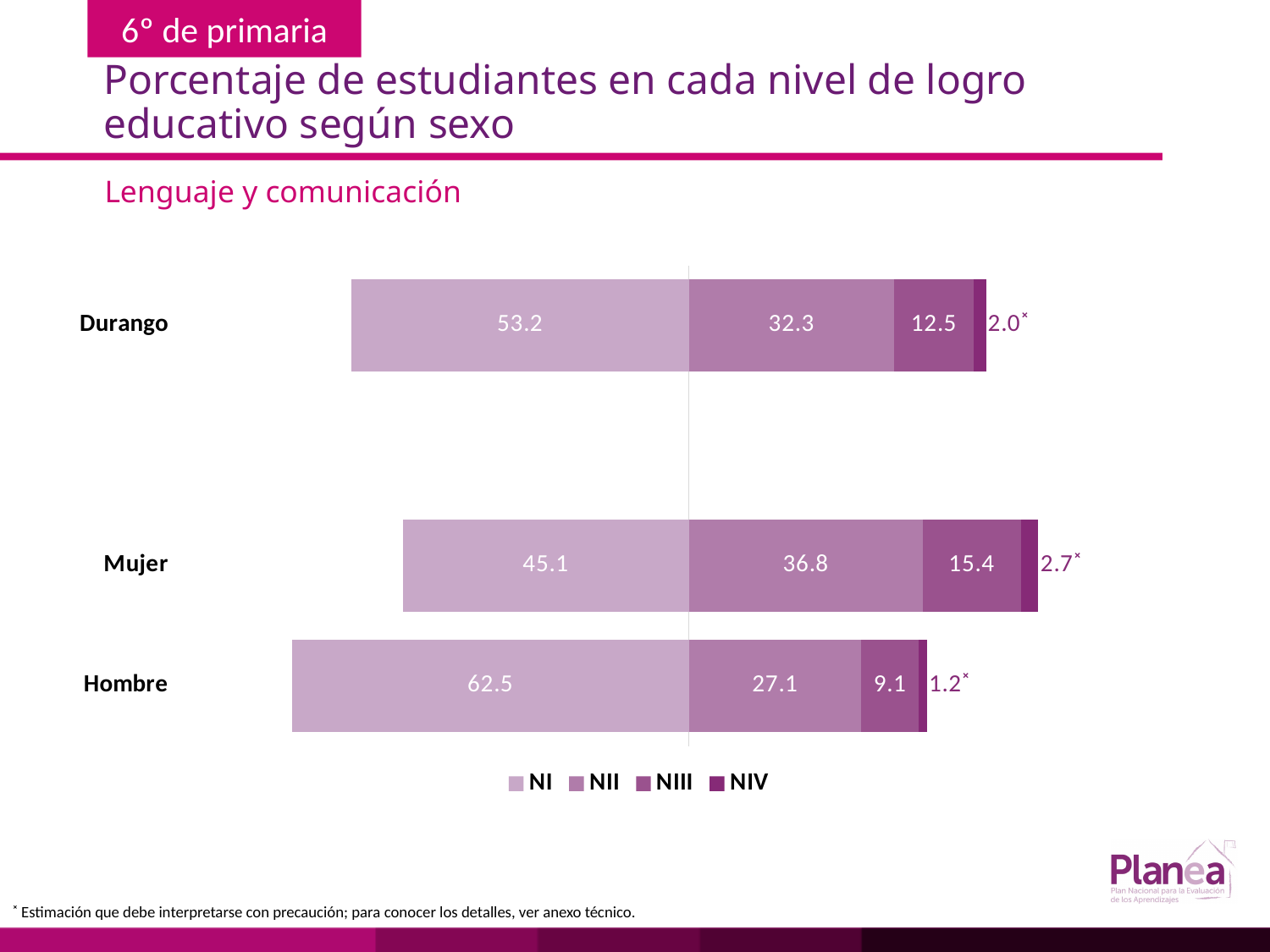
What kind of chart is shown on the slide? Stacked bar chart Which category has the highest NI value? Hombre What is the NI value for Hombre? 62.5 Which category has the lowest NIII value? Hombre What is the total of the stacked bar for Hombre? 99.9 How many series does the legend list? 4 What is the NIII value for Durango? 12.5 What is the NII value for Mujer? 36.8 What is the NIV value for Mujer? 2.7 Which is larger, the NII value for Durango or the NII value for Mujer? Mujer What is the difference between the NI values for Hombre and Mujer? 17.4 How many categories are shown on the chart? 3